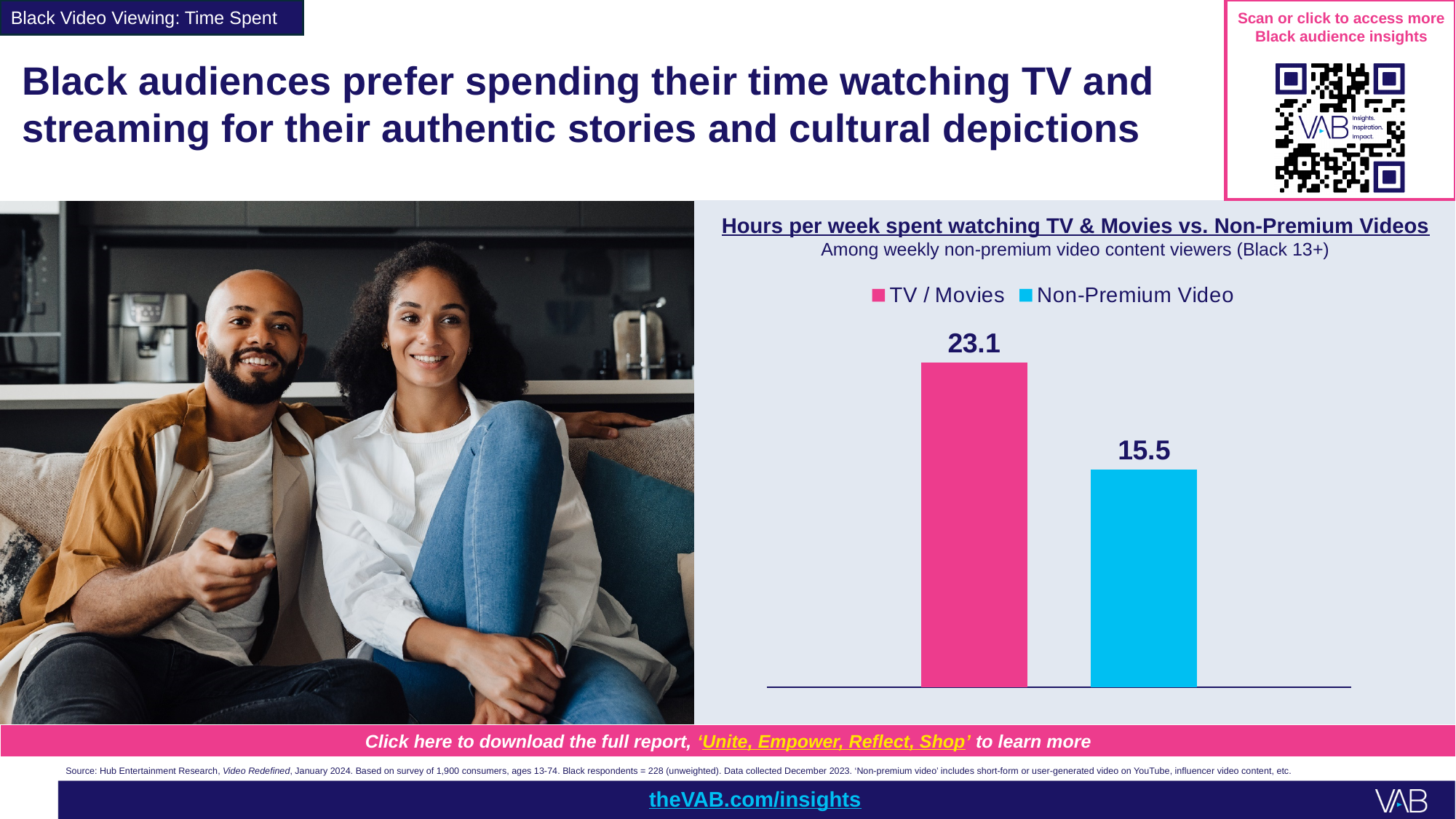
How many bars are plotted in the chart? 2 What is the difference between the TV / Movies value and the Non-Premium Video value? 7.6 What kind of chart is shown on the slide? bar chart Which category has the lowest value in the chart? Non-Premium Video Which category has the higher value, TV / Movies or Non-Premium Video? TV / Movies How many entries does the chart legend list? 2 What colour is the bar for Non-Premium Video? blue How many hours per week are spent watching Non-Premium Video? 15.5 Is the value for Non-Premium Video larger or smaller than the value for TV / Movies? smaller What is the title of the chart? Hours per week spent watching TV & Movies vs. Non-Premium Videos How many hours per week are spent watching TV / Movies? 23.1